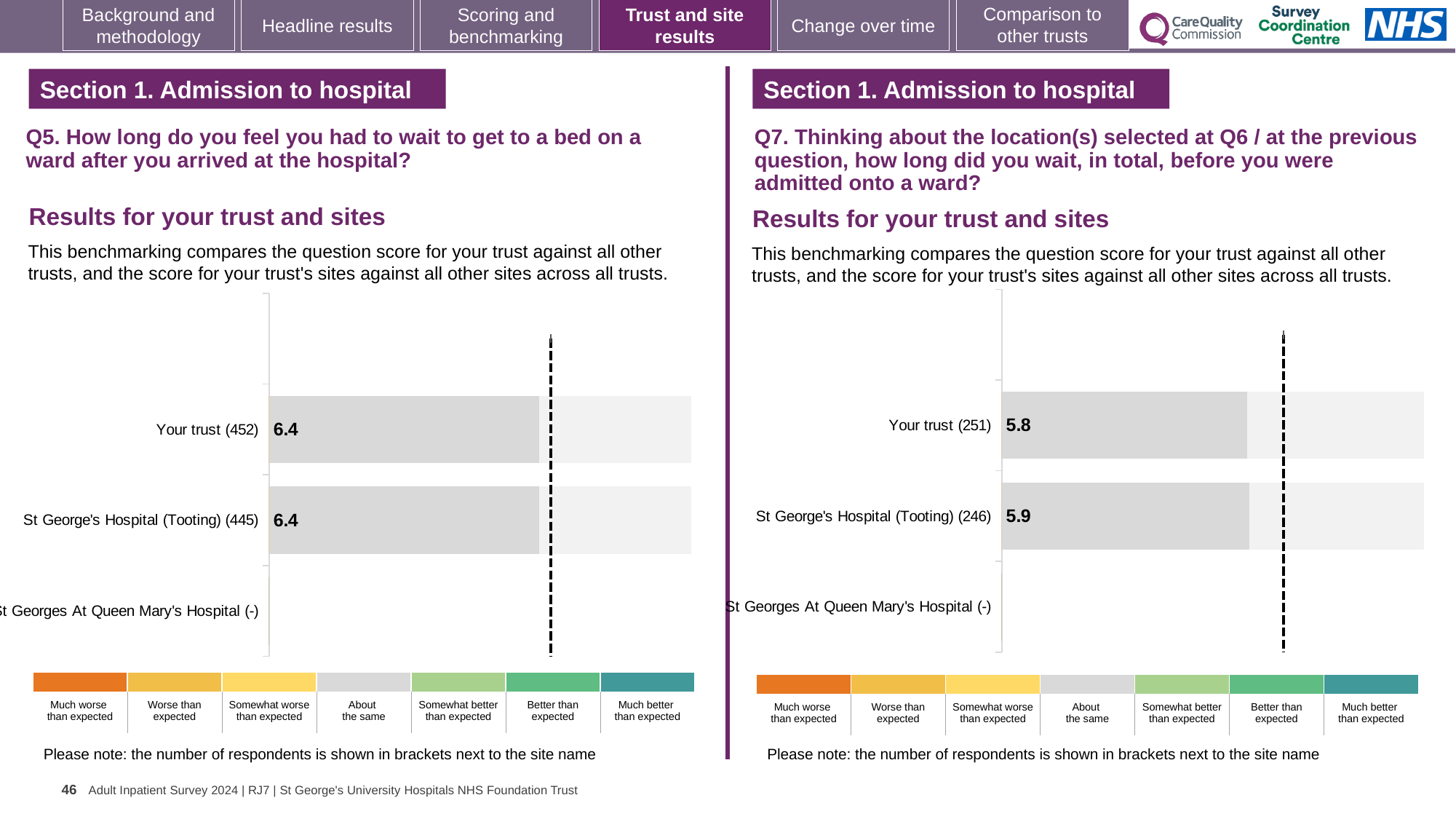
In the Q7 chart on the right, which has the higher score: Your trust or St George's Hospital (Tooting)? St George's Hospital (Tooting) In the Q5 chart on the left, which category has no bar plotted? St Georges At Queen Mary's Hospital (-) How many benchmark categories does the colour key below the Q5 chart on the left show? 7 In the Q5 chart on the left, how many categories are listed on the vertical axis? 3 In the Q7 chart on the right, what is the score for St George's Hospital (Tooting) (246)? 5.9 What kind of chart is the Q7 chart on the right? Bar chart In the Q7 chart on the right, what is the score for Your trust (251)? 5.8 In the Q7 chart on the right, what is the difference between the score for St George's Hospital (Tooting) and the score for Your trust? 0.1 In the Q5 chart on the left, what is the score for Your trust (452)? 6.4 In the Q5 chart on the left, how many respondents are shown in brackets for St George's Hospital (Tooting)? 445 In the Q7 chart on the right, how many respondents are shown in brackets for Your trust? 251 In the Q5 chart on the left, what is the score for St George's Hospital (Tooting) (445)? 6.4